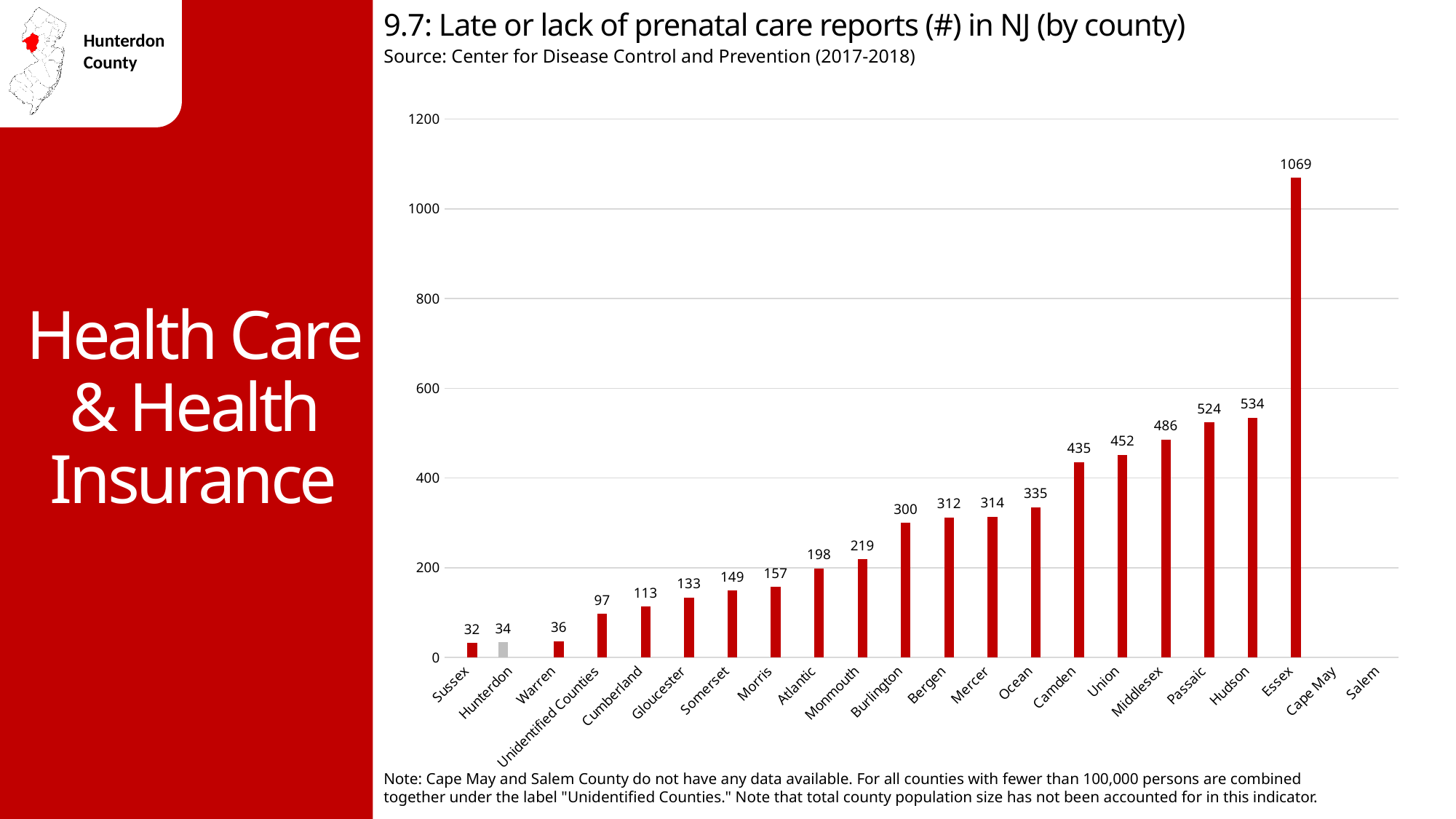
Which county has the highest number of late or lack of prenatal care reports? Essex What kind of chart is shown on the slide? Bar chart What is the difference between the values for Essex and Hudson? 535 What is the value for Monmouth? 219 Is the value for Middlesex greater or less than 400? greater What is the value for Hunterdon? 34 What is the value for Essex? 1069 Which is larger, the value for Camden or the value for Ocean? Camden Which two counties are noted as having no data available? Cape May and Salem What is the difference between the values for Hudson and Passaic? 10 Which county has the lowest number of late or lack of prenatal care reports among those with data? Sussex How many county labels are shown on the x axis? 22